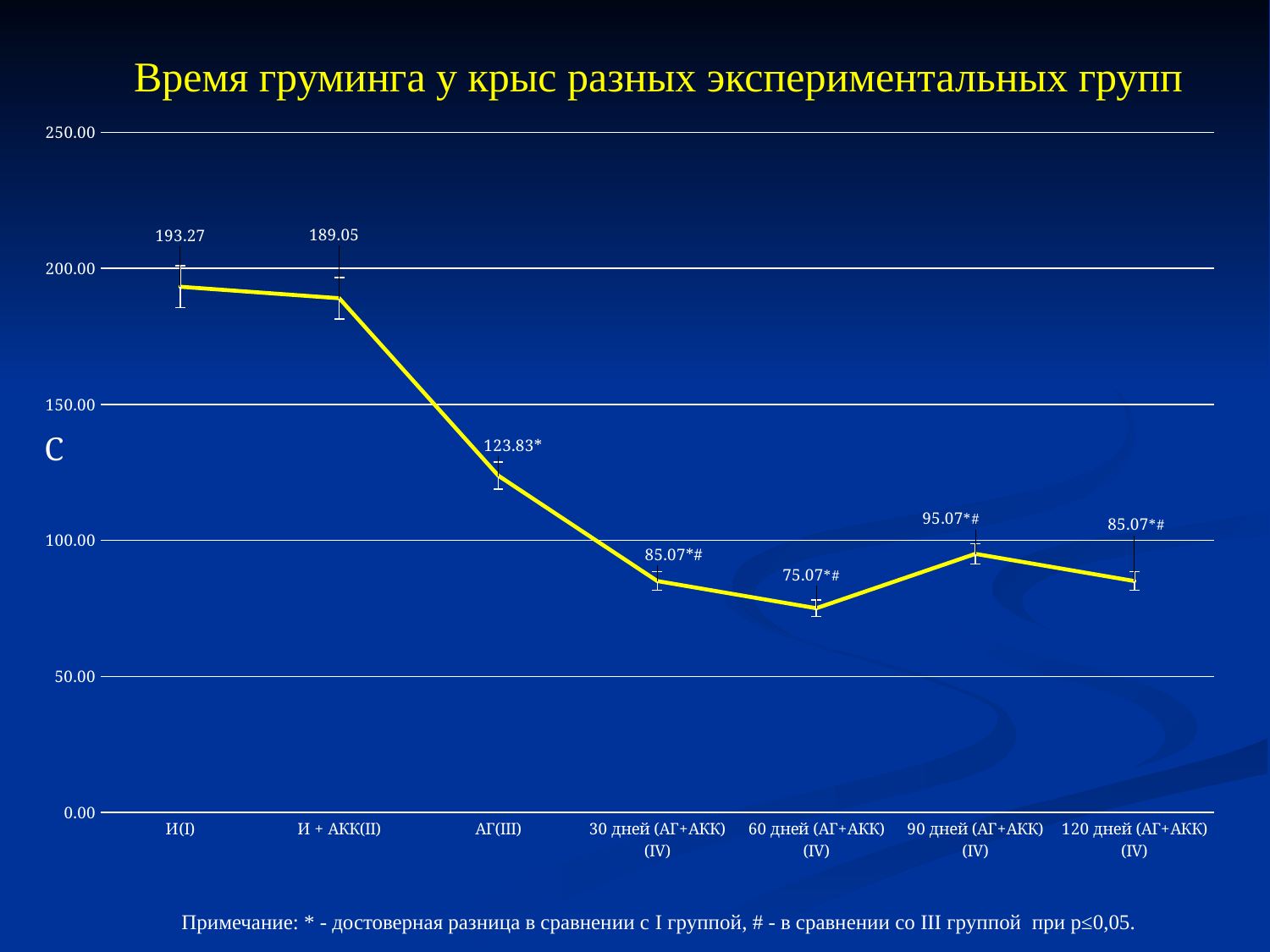
What value is shown for the 60 дней (АГ+АКК) (IV) group? 75.07 What value is shown for the АГ(III) group? 123.83 Which group has the lowest grooming time? 60 дней (АГ+АКК) (IV) What value is shown for the 90 дней (АГ+АКК) (IV) group? 95.07 Which is larger, the value for АГ(III) or the value for 90 дней (АГ+АКК) (IV)? АГ(III) What is the grooming time value for the И(I) group? 193.27 What type of chart is shown on the slide? Line chart What is the difference between the values for 90 дней (АГ+АКК) (IV) and 60 дней (АГ+АКК) (IV)? 20.00 What is the difference between the values for И(I) and И + АКК(II)? 4.22 Do the values generally rise or fall from the first group to the last group along the x axis? Fall How many groups are plotted along the x axis? 7 Which group has the highest grooming time? И(I)